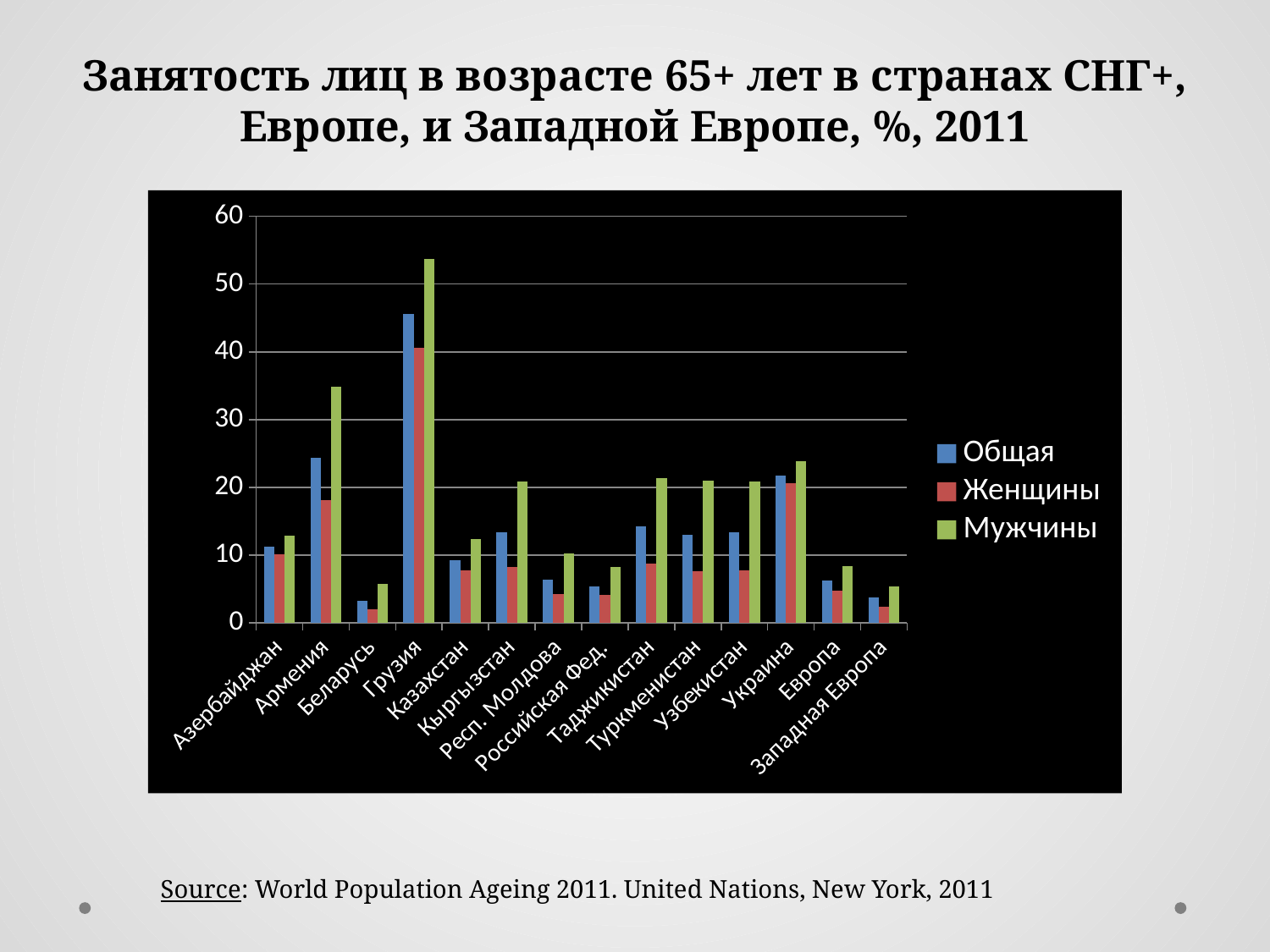
How many countries or regions are shown on the x axis? 14 What are the three series listed in the legend? Общая, Женщины, Мужчины Is the Общая value for Российская Фед. greater or less than 10? less Which country has the highest value for the Мужчины series? Грузия Which is larger, the Общая value for Армения or the Общая value for Украина? Армения Is the Мужчины value for Грузия greater or less than 50? greater Which country has the highest value for the Общая series? Грузия How many series does the legend list? 3 Is the Мужчины value for Армения greater or less than 30? greater What kind of chart is shown on the slide? bar chart Which is larger, the Мужчины value for Таджикистан or the Мужчины value for Азербайджан? Таджикистан